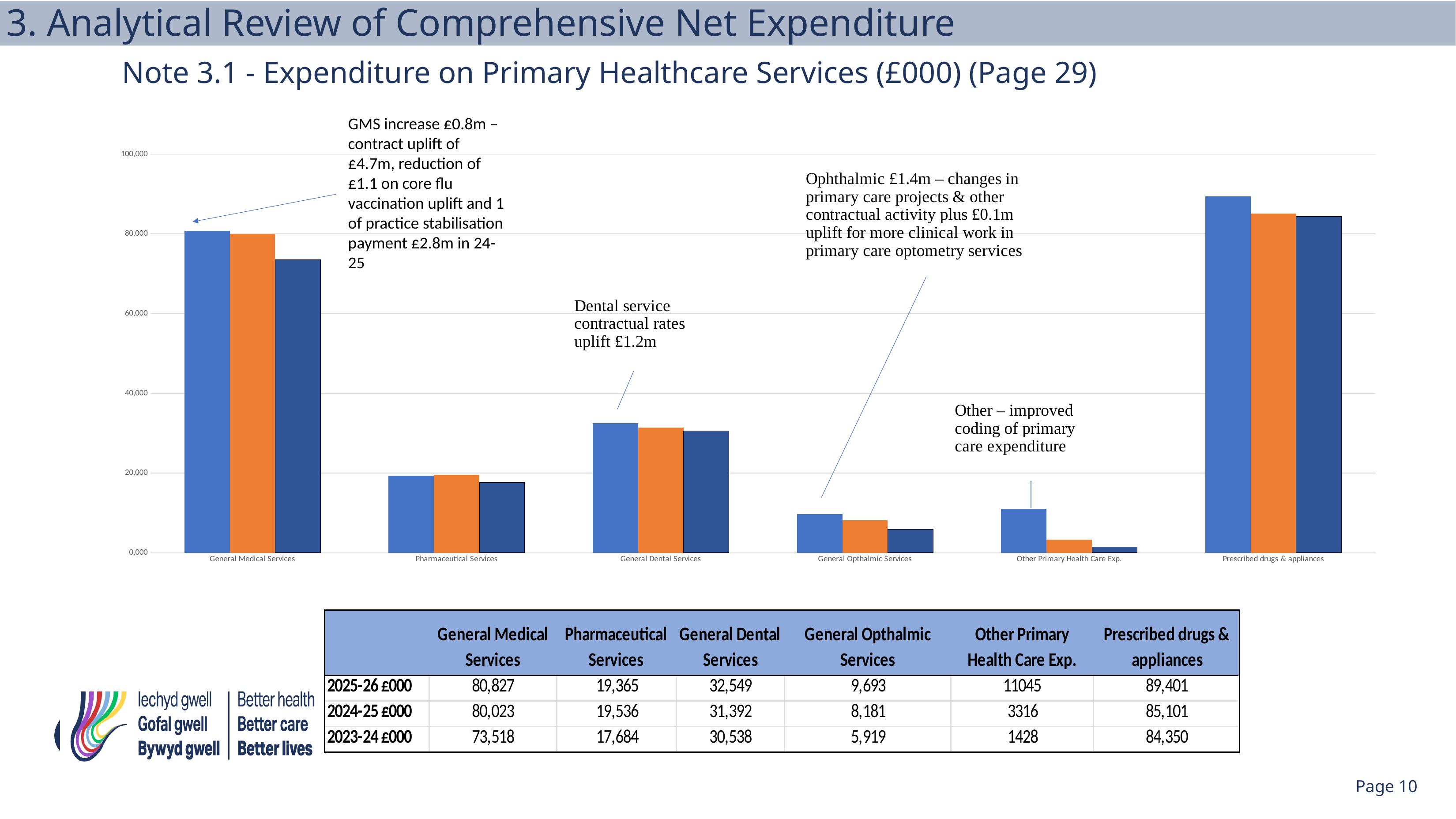
Which is larger for Pharmaceutical Services: the 2025-26 value or the 2024-25 value? 2024-25 Which category has the highest 2025-26 value? Prescribed drugs & appliances Is the 2025-26 value for General Medical Services greater or less than 80,000? greater Which category has the lowest 2023-24 value? Other Primary Health Care Exp. What is the difference between the 2025-26 and 2023-24 values for Other Primary Health Care Exp.? 9617 How many categories are shown on the x axis of the chart? 6 What is the 2025-26 value for General Medical Services? 80,827 What kind of chart is shown on the slide? bar chart Is the 2023-24 value for Pharmaceutical Services greater or less than 20,000? less What is the difference between the 2025-26 and 2024-25 values for General Dental Services? 1,157 What is the 2024-25 value for General Opthalmic Services? 8,181 What is the 2023-24 value for Prescribed drugs & appliances? 84,350